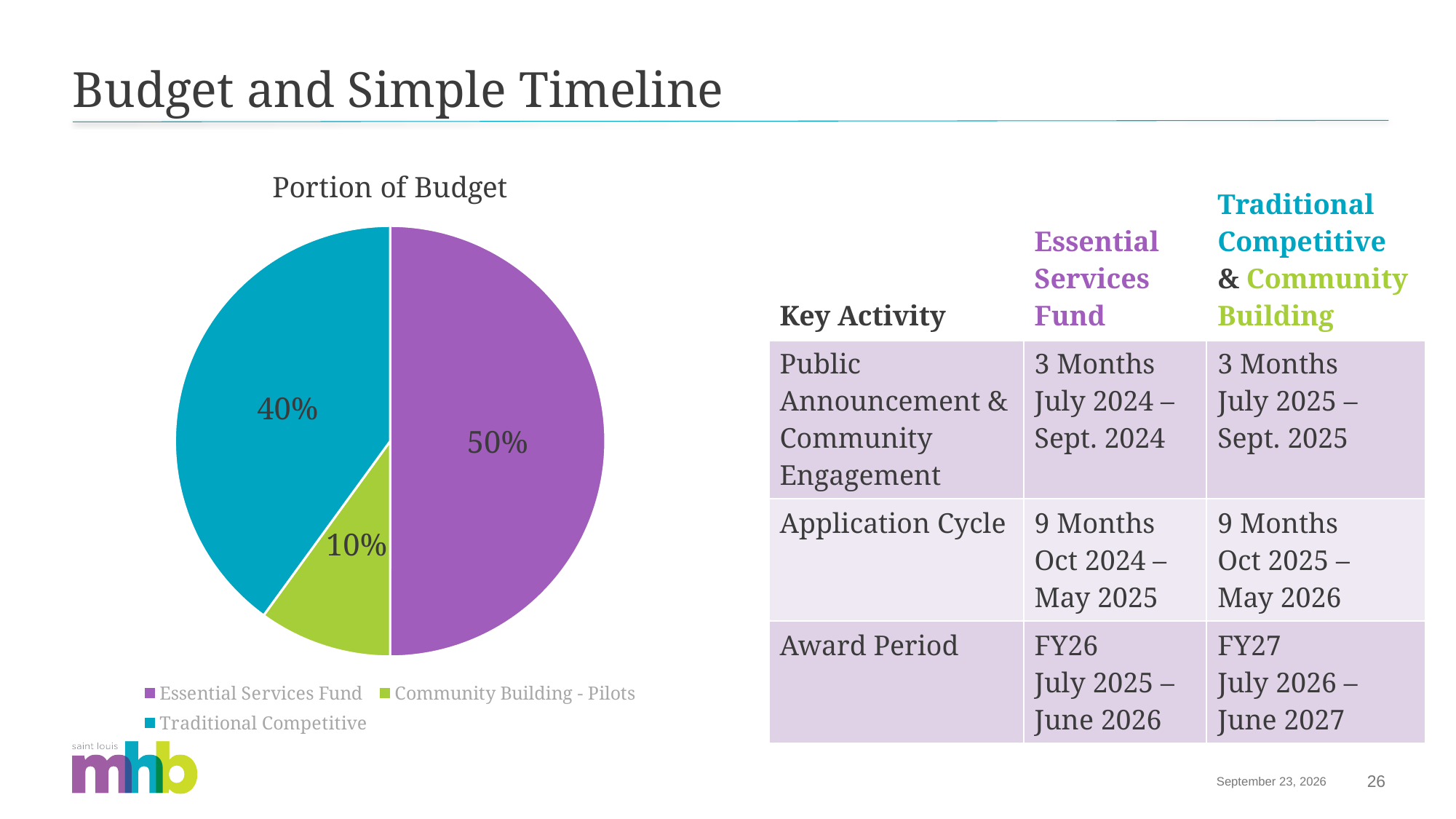
What share of the budget does the Essential Services Fund slice represent? 50% What is the title of the chart? Portion of Budget What colour is the Traditional Competitive slice? Teal What type of chart is shown on the slide? Pie chart How many slices does the pie chart have? 3 What is the difference in percentage points between the Essential Services Fund and Traditional Competitive slices? 10% What share of the budget does the Traditional Competitive slice represent? 40% Which is larger, the Traditional Competitive slice or the Community Building - Pilots slice? Traditional Competitive What is the difference in percentage points between the Traditional Competitive and Community Building - Pilots slices? 30% Which category has the largest share of the budget? Essential Services Fund Which category has the smallest share of the budget? Community Building - Pilots What share of the budget does the Community Building - Pilots slice represent? 10%